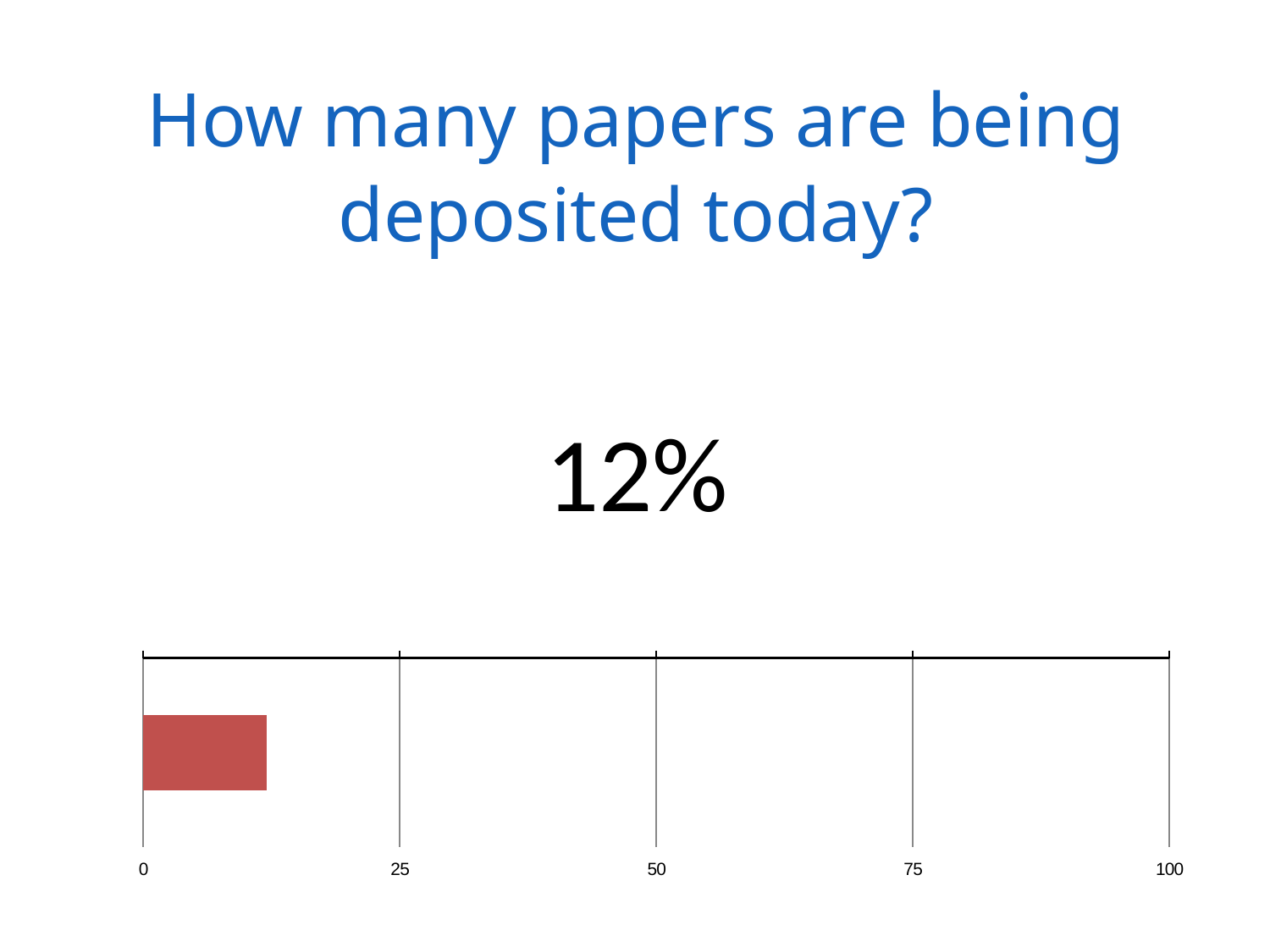
Is the value of the bar greater or less than 25? less What kind of chart is shown on the slide? bar chart What value does the bar in the chart represent, as printed on the slide? 12% Is the value of the bar greater or less than 50? less What is the highest tick value shown on the chart's axis? 100 What question does the slide title ask above the chart? How many papers are being deposited today? How many bars are plotted in the chart? 1